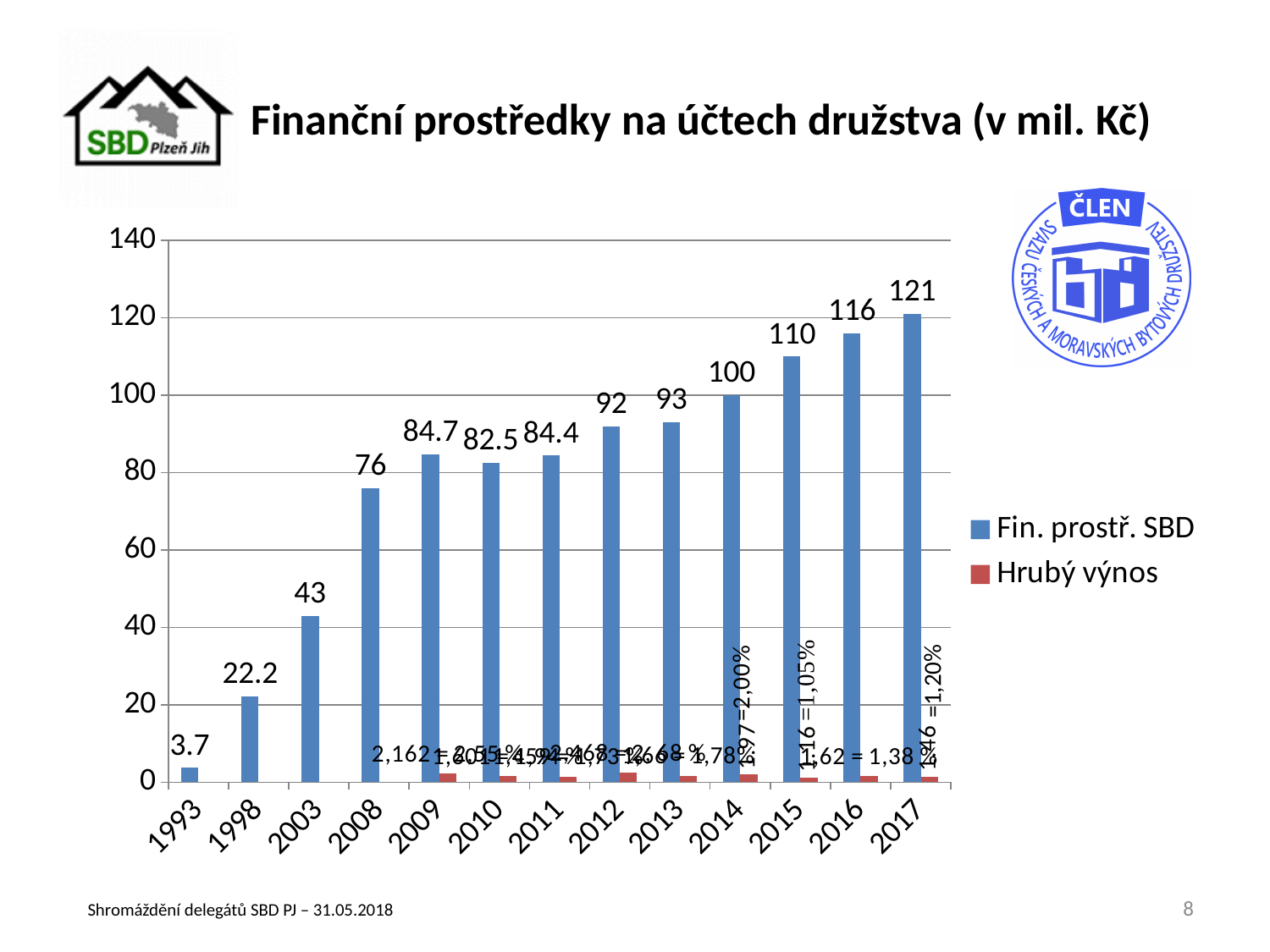
Which year has a larger Fin. prostř. SBD value, 2010 or 2011? 2011 How many series does the legend list? 2 How many years are shown on the x axis? 13 What is the value of Fin. prostř. SBD for 2017? 121 Which year has the highest value for Fin. prostř. SBD? 2017 What is the value of Fin. prostř. SBD for 2009? 84.7 What is the value of Fin. prostř. SBD for 1998? 22.2 What kind of chart is shown on the slide? Bar chart What is the title of the chart? Finanční prostředky na účtech družstva (v mil. Kč) Which year has the lowest value for Fin. prostř. SBD? 1993 What is the value of Fin. prostř. SBD for 2014? 100 What is the difference between the Fin. prostř. SBD values for 2017 and 2016? 5